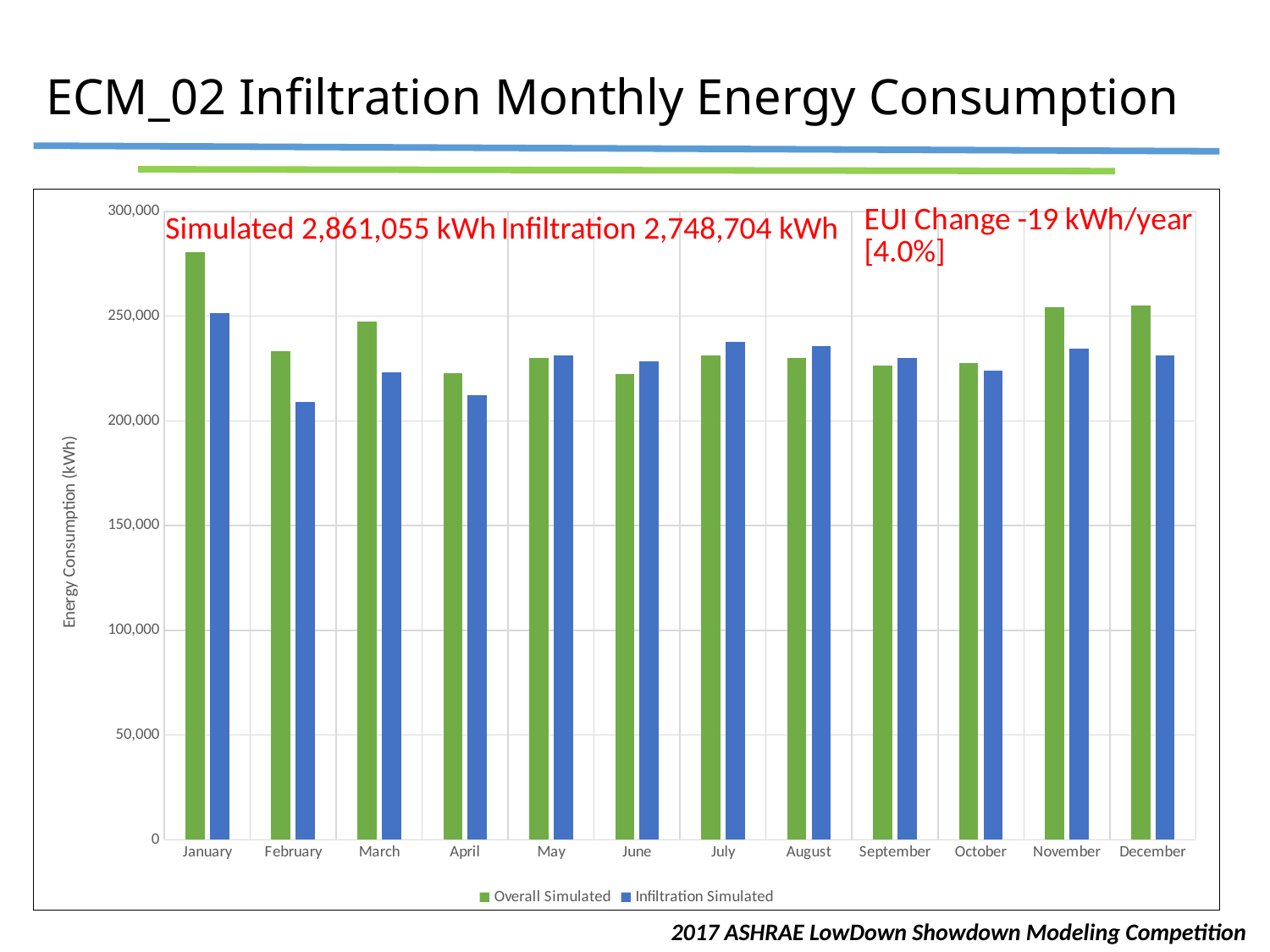
What is the label on the y axis of the chart? Energy Consumption (kWh) What kind of chart is shown on the slide? bar chart How many months are shown on the x axis of the chart? 12 What total Simulated energy consumption in kWh is stated in the red text on the chart? 2,861,055 kWh In July, which is larger: Overall Simulated or Infiltration Simulated? Infiltration Simulated Which month has the lowest Infiltration Simulated energy consumption? February Which month has the highest Overall Simulated energy consumption? January Which month has the highest Infiltration Simulated energy consumption? January How many series does the chart's legend list? 2 Is the Infiltration Simulated value for February greater or less than 250,000? less Is the Overall Simulated value for January greater or less than 250,000? greater In January, which is larger: Overall Simulated or Infiltration Simulated? Overall Simulated